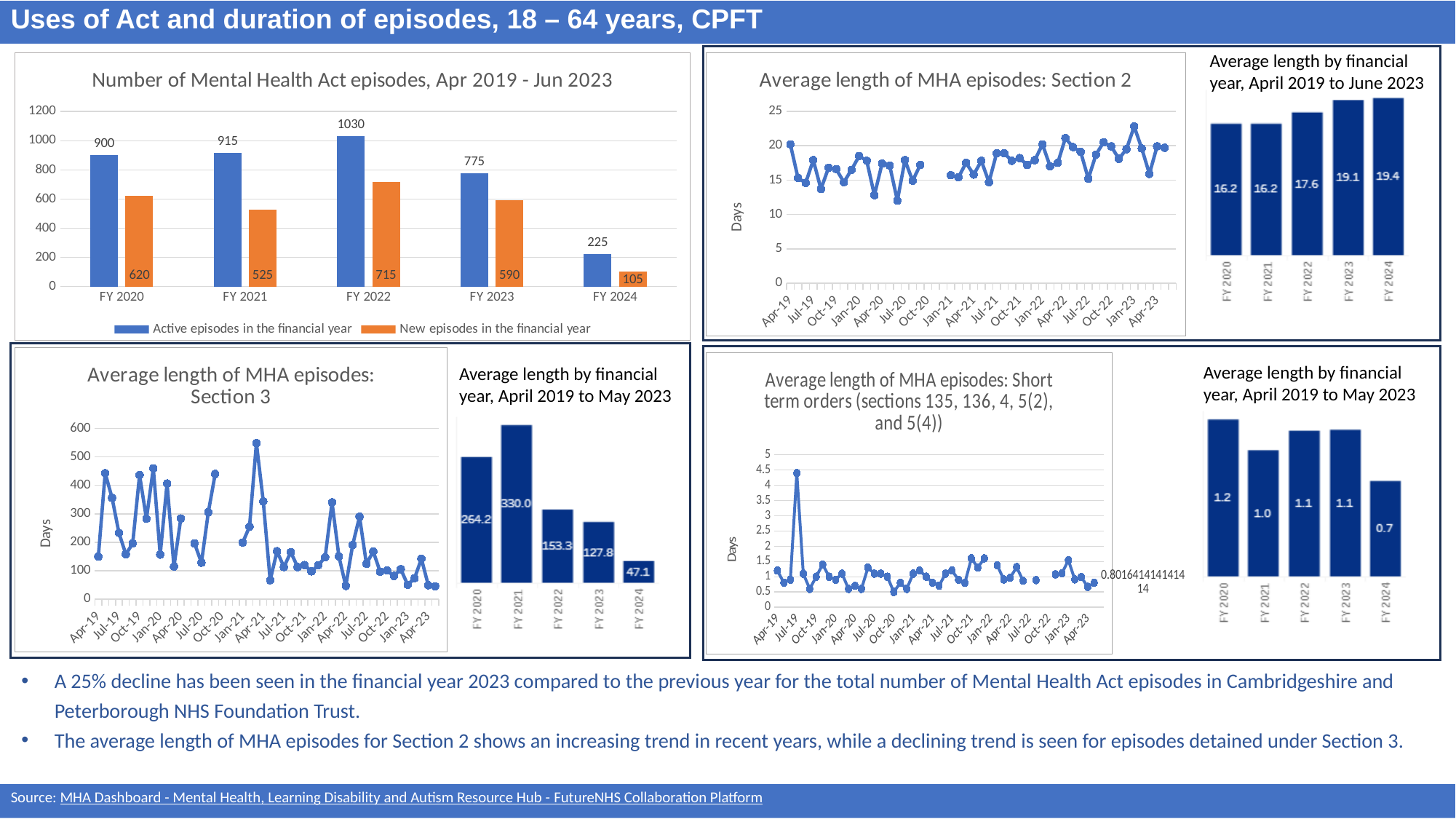
In the 'Number of Mental Health Act episodes, Apr 2019 - Jun 2023' chart, what is the difference between active episodes and new episodes in FY 2023? 185 In the 'Number of Mental Health Act episodes, Apr 2019 - Jun 2023' chart, which financial year has the highest number of active episodes? FY 2022 In the Section 2 'Average length by financial year, April 2019 to June 2023' bar chart, do the values rise or fall from FY 2020 to FY 2024? rise In the Section 3 'Average length by financial year, April 2019 to May 2023' bar chart, what is the value for FY 2024? 47.1 In the Section 3 'Average length by financial year, April 2019 to May 2023' bar chart, which financial year has the highest value? FY 2021 In the 'Number of Mental Health Act episodes, Apr 2019 - Jun 2023' chart, how many new episodes were there in FY 2021? 525 In the Section 2 'Average length by financial year, April 2019 to June 2023' bar chart, what is the value for FY 2023? 19.1 In the Short term orders 'Average length by financial year, April 2019 to May 2023' bar chart, which financial year has the lowest value? FY 2024 In the 'Number of Mental Health Act episodes, Apr 2019 - Jun 2023' chart, how many financial years are shown on the x axis? 5 In the 'Number of Mental Health Act episodes, Apr 2019 - Jun 2023' chart, how many active episodes were there in FY 2022? 1030 What kind of chart is 'Average length of MHA episodes: Section 2'? line chart In the 'Number of Mental Health Act episodes, Apr 2019 - Jun 2023' chart, how many series does the legend list? 2